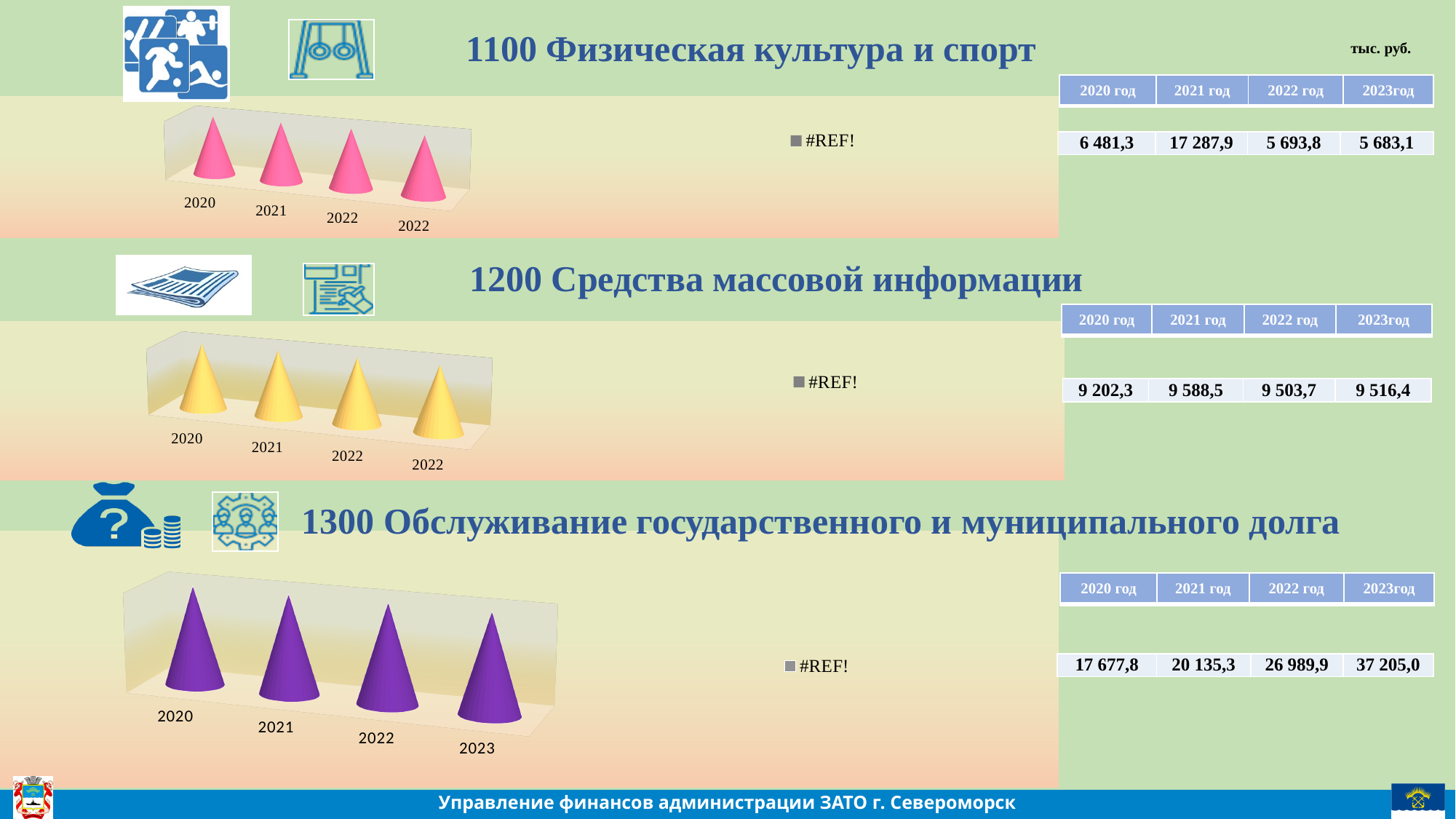
In the table beside the chart '1300 Обслуживание государственного и муниципального долга', do the values rise or fall from 2020 год to 2023год? rise In the table beside the chart '1100 Физическая культура и спорт', which year has the lowest value? 2023год How many categories are plotted on the x axis of the chart under '1300 Обслуживание государственного и муниципального долга'? 4 What colour are the cones in the chart under '1300 Обслуживание государственного и муниципального долга'? purple What kind of chart is shown under the heading '1100 Физическая культура и спорт'? bar chart In the table beside the chart '1300 Обслуживание государственного и муниципального долга', which year has the highest value? 2023год In the table beside the chart '1100 Физическая культура и спорт', what is the value for 2021 год? 17 287,9 What text appears as the legend entry for the chart under '1100 Физическая культура и спорт'? #REF! In the table beside the chart '1200 Средства массовой информации', which is larger, the value for 2021 год or for 2022 год? 2021 год In the table beside the chart '1300 Обслуживание государственного и муниципального долга', what is the difference between the 2023год and 2022 год values? 10 215,1 In the table beside the chart '1200 Средства массовой информации', what is the value for 2023год? 9 516,4 How many series does the legend of the chart under '1200 Средства массовой информации' list? 1